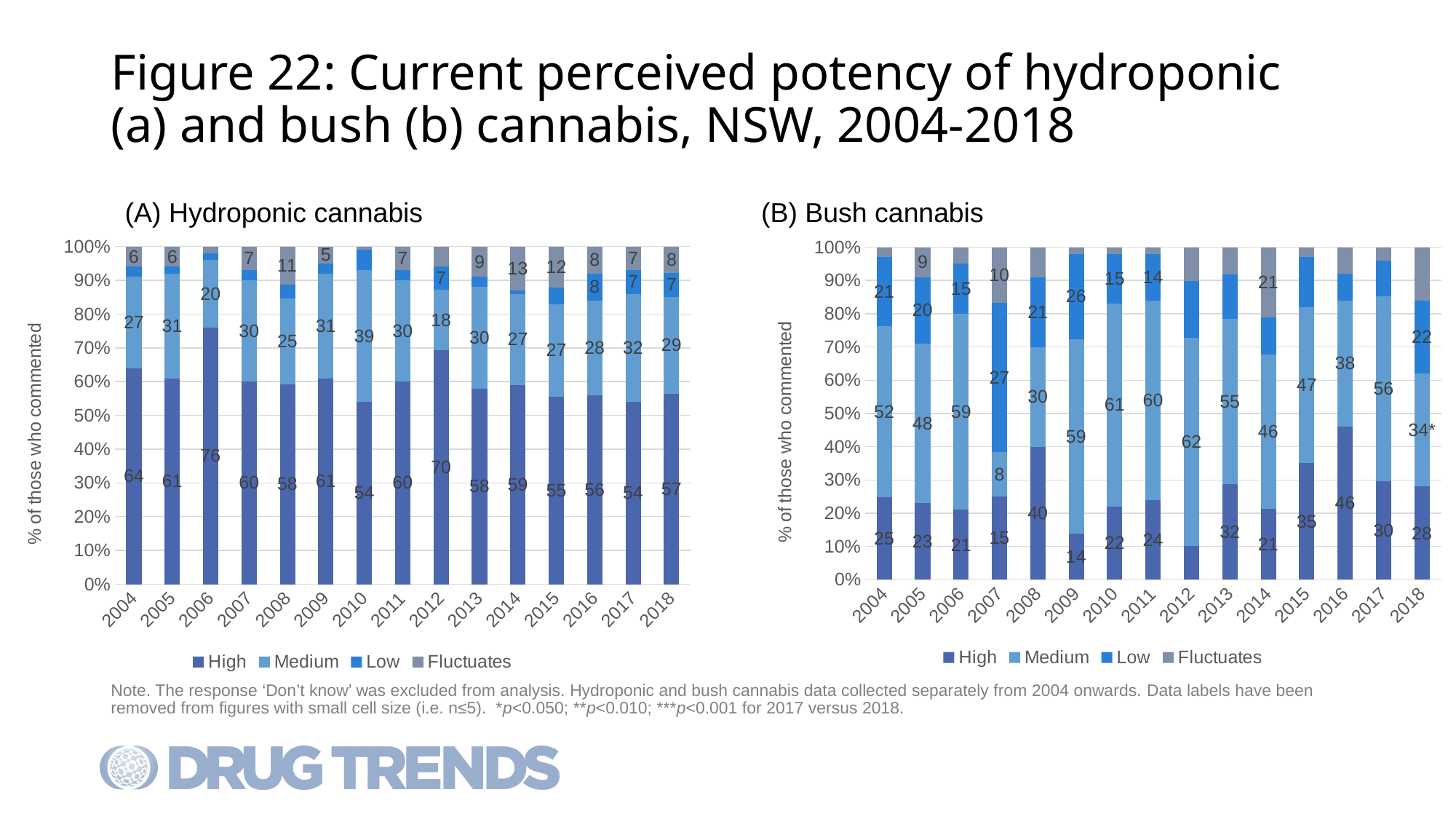
In the (A) Hydroponic cannabis chart, what is the value for Medium in 2010? 39 In the (A) Hydroponic cannabis chart, which year has the highest value for High? 2006 In the (B) Bush cannabis chart, which year has the larger High value, 2008 or 2016? 2016 What is the y-axis label of the (B) Bush cannabis chart? % of those who commented What kind of chart is used for (A) Hydroponic cannabis? Stacked bar chart In the (A) Hydroponic cannabis chart, what is the value for High in 2006? 76 How many years are shown on the x axis of the (A) Hydroponic cannabis chart? 15 In the (A) Hydroponic cannabis chart, what is the difference between the High values for 2018 and 2017? 3 How many series does the legend of the (B) Bush cannabis chart list? 4 In the (B) Bush cannabis chart, which year has the lowest value for Medium? 2007 In the (B) Bush cannabis chart, what is the value for Fluctuates in 2014? 21 In the (B) Bush cannabis chart, what is the value for Medium in 2018? 34*